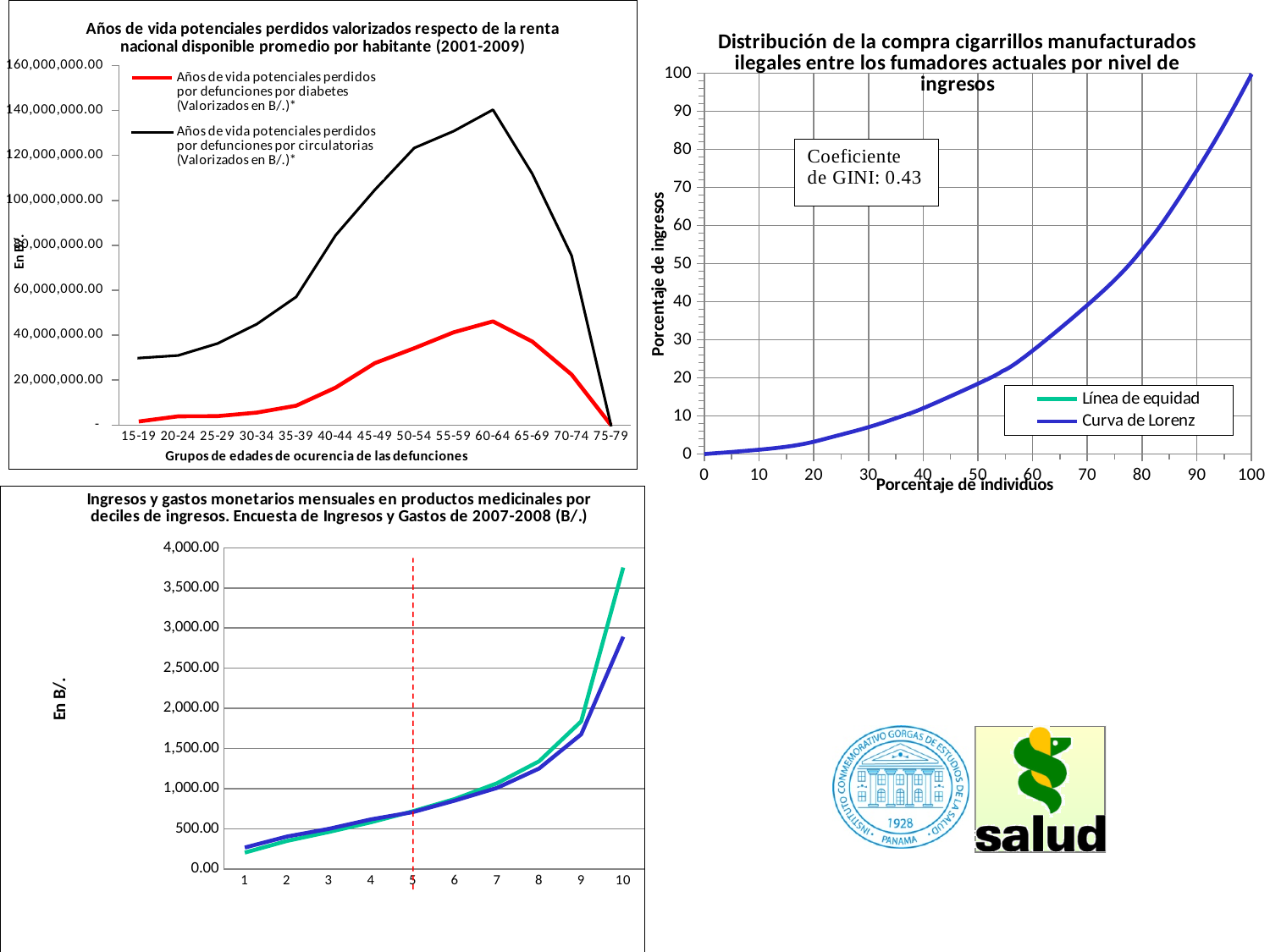
In the top-left chart (Años de vida potenciales perdidos), is the value for defunciones por diabetes at age group 60-64 greater or less than 60,000,000.00? less In the top-left chart (Años de vida potenciales perdidos), at age group 50-54, which series has the larger value: defunciones por diabetes or defunciones por circulatorias? Defunciones por circulatorias In the top-right chart (Distribución de la compra cigarrillos manufacturados ilegales), is the value of the Curva de Lorenz at 90 percent of individuals greater or less than 70? greater What kind of chart is the top-left chart titled 'Años de vida potenciales perdidos valorizados respecto de la renta nacional disponible promedio por habitante (2001-2009)'? Line chart In the top-left chart (Años de vida potenciales perdidos), for which age group is the value for defunciones por circulatorias highest? 60-64 In the bottom-left chart (Ingresos y gastos monetarios mensuales en productos medicinales), how many deciles are shown on the x axis? 10 In the top-right chart (Distribución de la compra cigarrillos manufacturados ilegales), how many entries does the legend list? 2 In the top-right chart (Distribución de la compra cigarrillos manufacturados ilegales), what is the Coeficiente de GINI shown? 0.43 In the top-left chart (Años de vida potenciales perdidos), how many series does the legend list? 2 In the top-left chart (Años de vida potenciales perdidos), is the value for defunciones por circulatorias at age group 60-64 greater or less than 120,000,000.00? greater In the top-left chart (Años de vida potenciales perdidos), how many age groups are shown on the x axis? 13